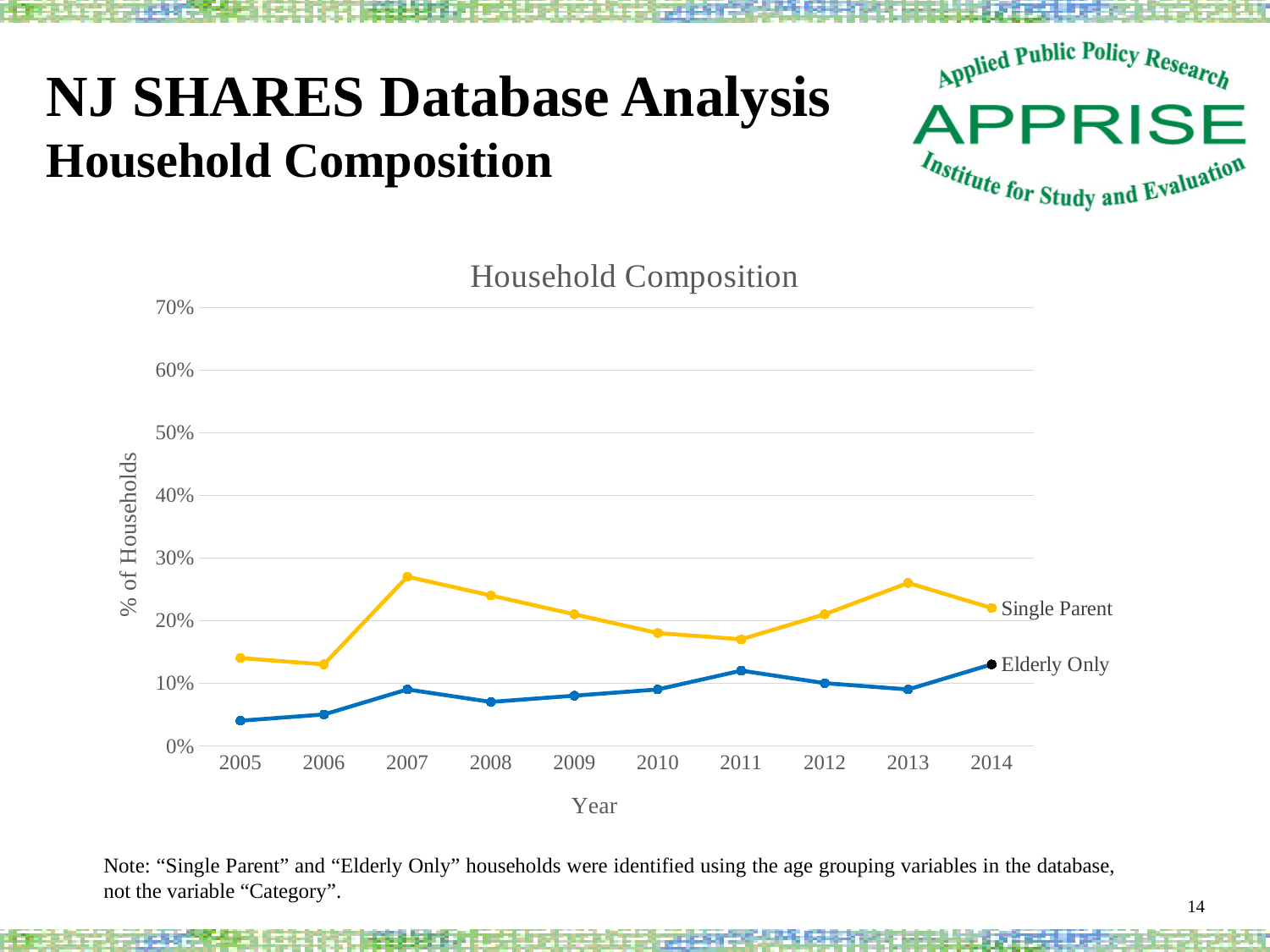
What kind of chart is shown on the slide? Line chart Does the Single Parent series rise or fall from 2007 to 2011? Fall How many series are plotted in the Household Composition chart? 2 Is the Single Parent value for 2011 greater or less than 20%? less Does the Elderly Only series rise or fall from 2005 to 2007? Rise What is the label on the y axis of the Household Composition chart? % of Households Is the Elderly Only value for 2005 greater or less than 10%? less Which series has the higher value in 2007, Single Parent or Elderly Only? Single Parent How many years are shown on the x axis of the Household Composition chart? 10 For the Single Parent series, which year has the higher value, 2006 or 2007? 2007 Is the Single Parent value for 2007 greater or less than 20%? greater